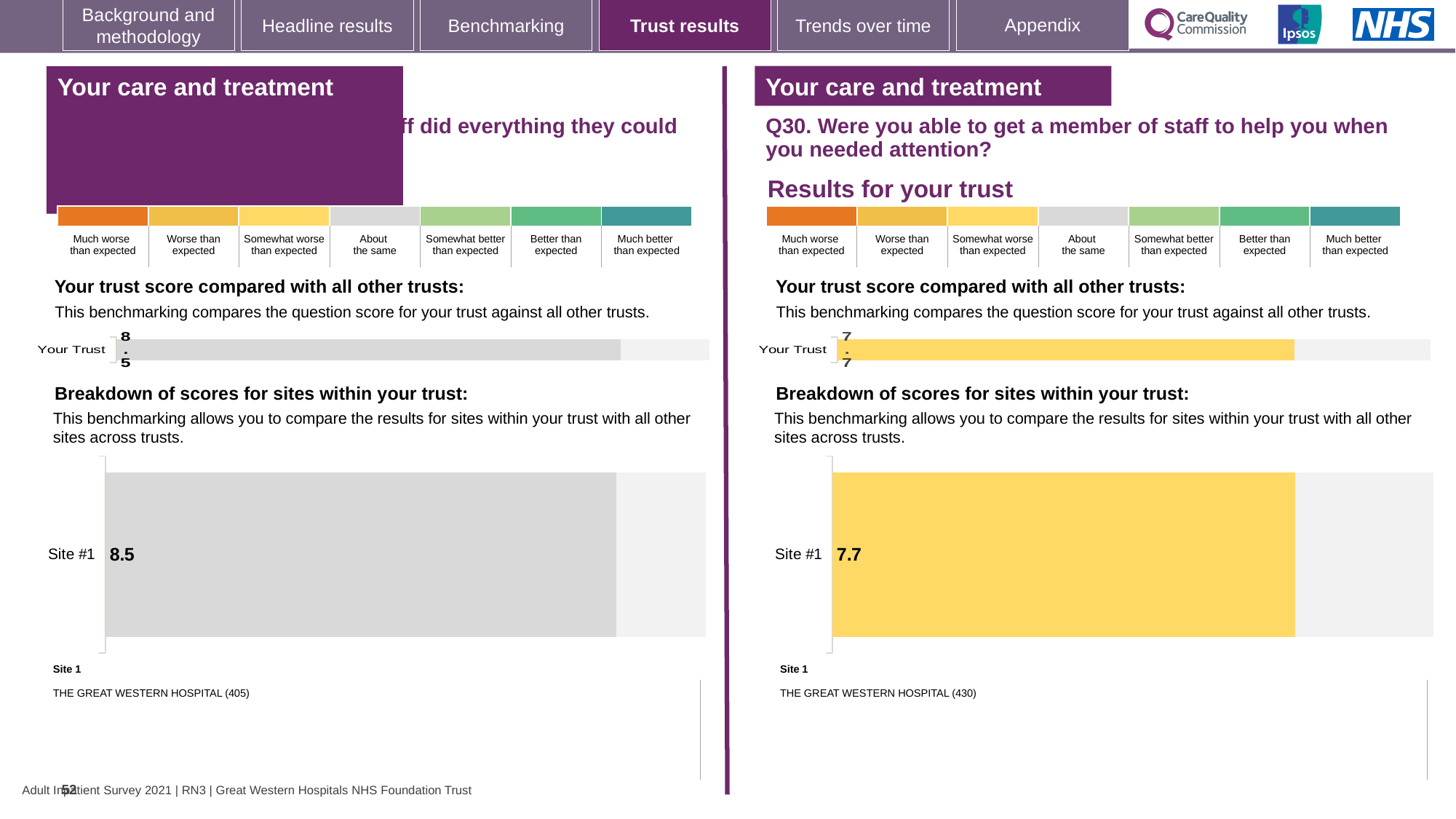
On the right-hand side of the slide (Q30), which site name is listed as Site 1? THE GREAT WESTERN HOSPITAL (430) On the left-hand side of the slide, what is the score shown for Your Trust in the trust comparison chart? 8.5 Which Site #1 score is larger: the one on the left-hand side of the slide or the one on the right-hand side (Q30)? Left-hand side On the right-hand side of the slide (Q30), what is the score shown for Site #1? 7.7 What type of chart is used to show the Site #1 score on the right-hand side of the slide (Q30)? Bar chart What colour is the Site #1 bar on the left-hand side of the slide? Grey How many sites are shown in the 'Breakdown of scores for sites within your trust' chart on the left-hand side of the slide? 1 On the right-hand side of the slide (Q30), what is the score shown for Your Trust in the trust comparison chart? 7.7 On the left-hand side of the slide, what is the score shown for Site #1? 8.5 What is the difference between the Site #1 score on the left-hand side of the slide and the Site #1 score on the right-hand side (Q30)? 0.8 How many sites are shown in the 'Breakdown of scores for sites within your trust' chart on the right-hand side of the slide (Q30)? 1 What colour is the Site #1 bar on the right-hand side of the slide (Q30)? Yellow